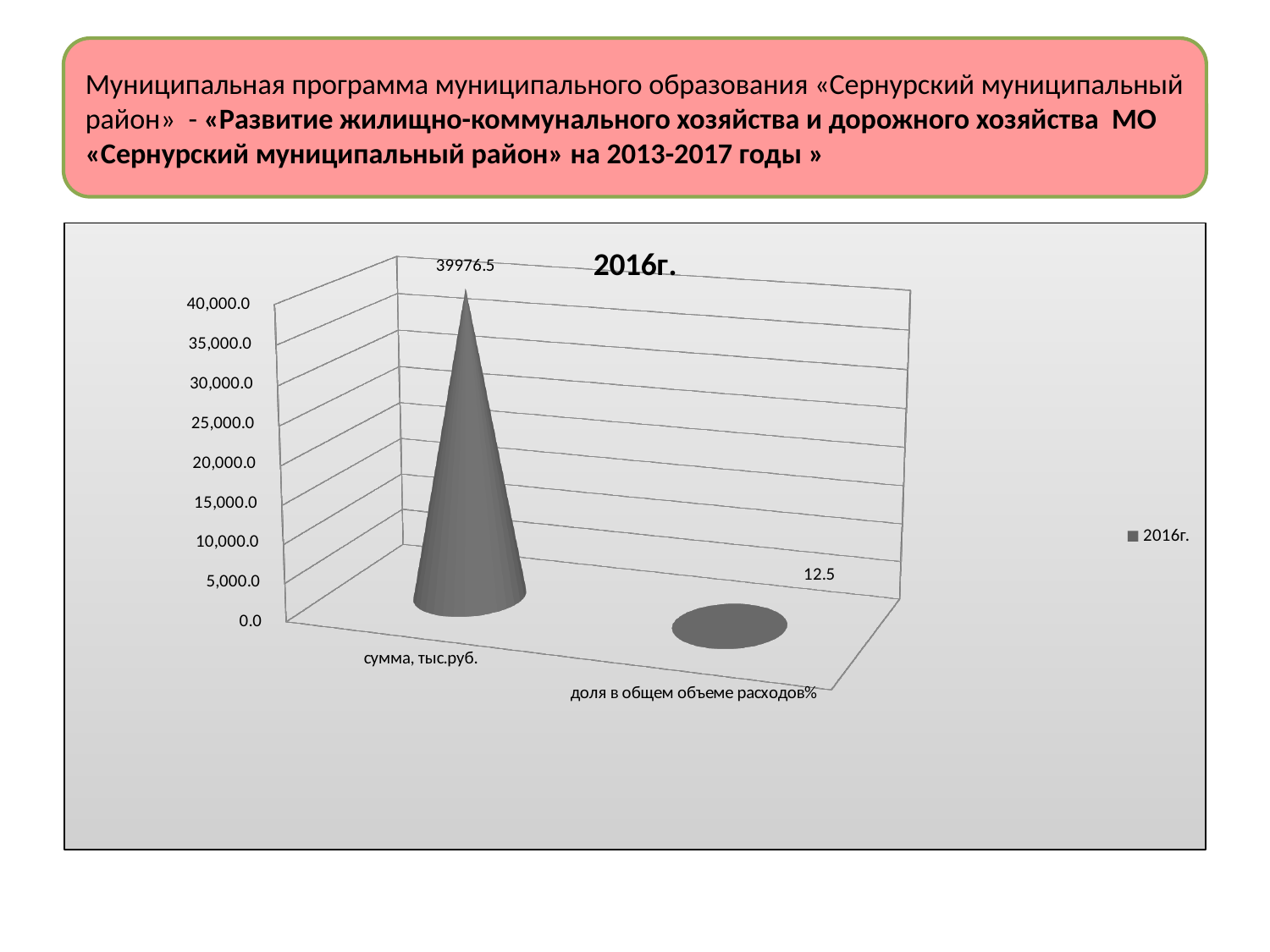
What is the value for «доля в общем объеме расходов%» in the chart? 12.5 How many series does the legend list? 1 What is the difference between the value for «сумма, тыс.руб.» and the value for «доля в общем объеме расходов%»? 39964 Which category has the highest value in the chart? сумма, тыс.руб. What is the title of the chart? 2016г. Is the value for «сумма, тыс.руб.» greater or less than 35,000.0? greater Is the value for «доля в общем объеме расходов%» greater or less than 5,000.0? less Which is larger: the value for «сумма, тыс.руб.» or the value for «доля в общем объеме расходов%»? сумма, тыс.руб. What is the highest value shown on the vertical axis of the chart? 40,000.0 What is the value for «сумма, тыс.руб.» in the chart? 39976.5 Which category has the lowest value in the chart? доля в общем объеме расходов% How many categories are shown in the chart? 2